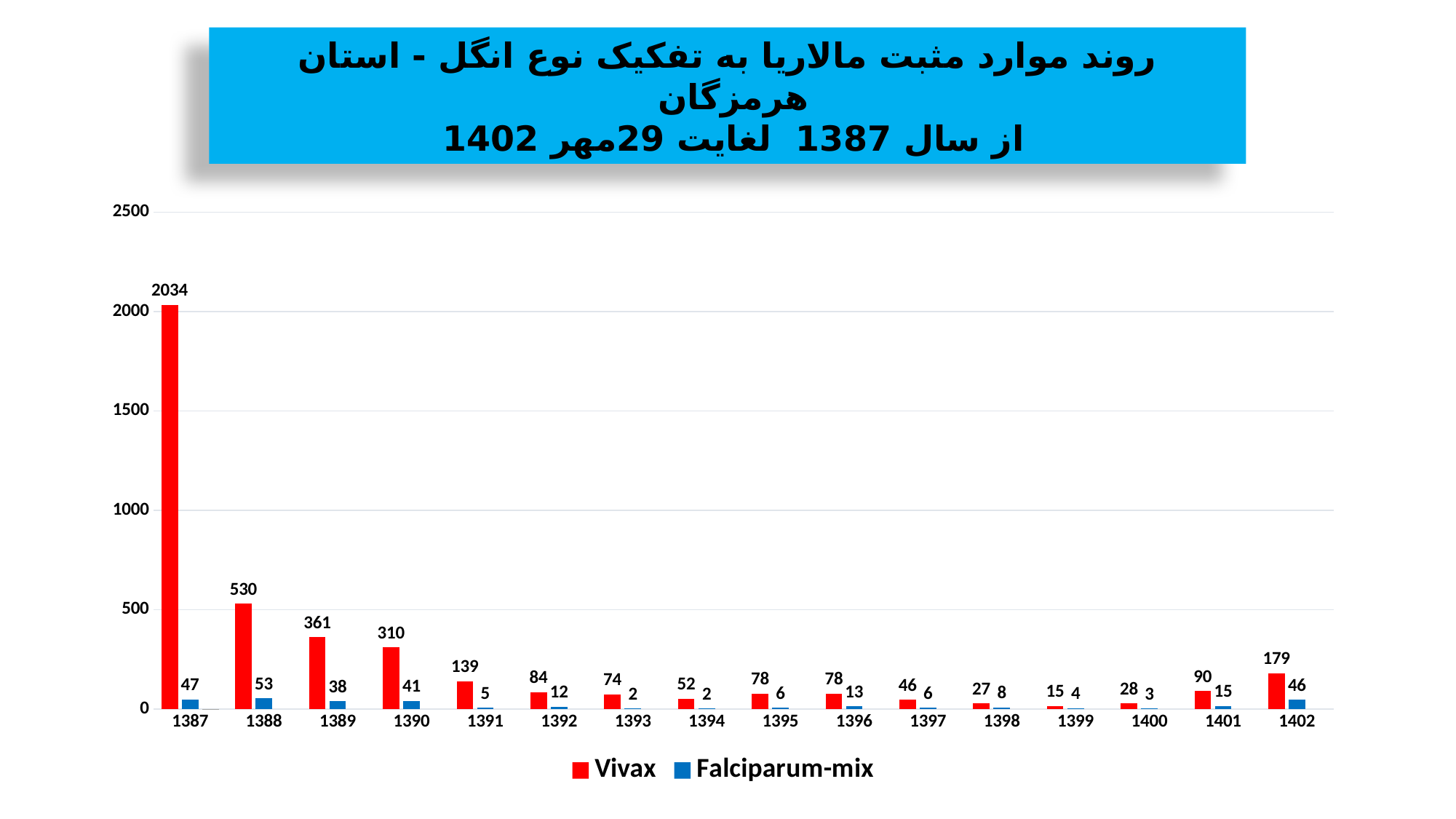
What is the difference between the Vivax values for 1388 and 1389? 169 Which is larger, the Vivax value for 1401 or the Vivax value for 1402? 1402 Is the Vivax value for 1390 greater or less than 500? less What is the Vivax value for 1402? 179 What is the Vivax value for 1387? 2034 Which year has the lowest Vivax value? 1399 What is the Falciparum-mix value for 1388? 53 How many years are shown on the x axis? 16 What kind of chart is shown on the slide? bar chart What colour represents the Falciparum-mix series? blue Which year has the highest Vivax value? 1387 How many series does the legend list? 2